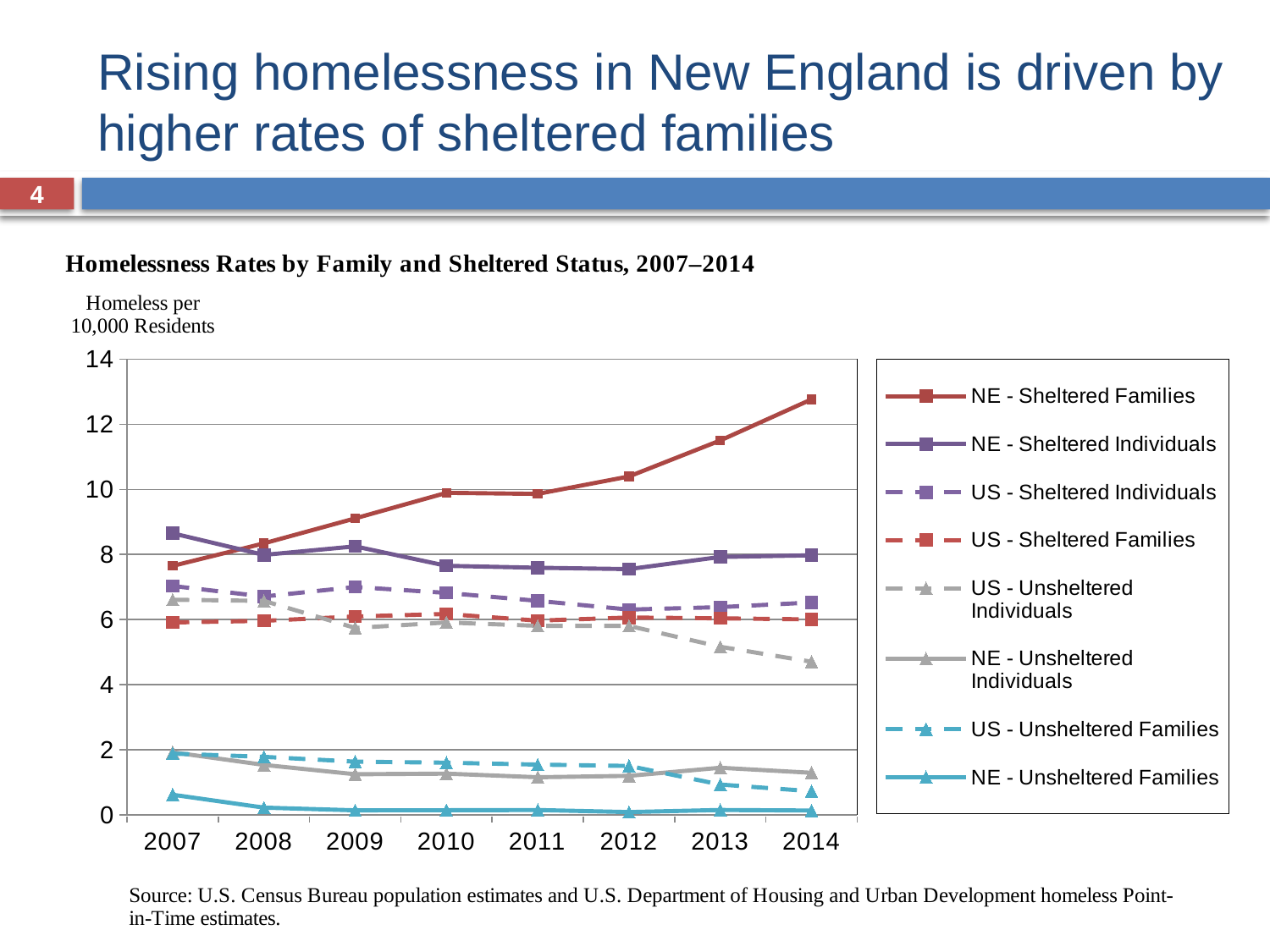
In 2007, which is higher: NE - Sheltered Individuals or NE - Sheltered Families? NE - Sheltered Individuals Does the NE - Sheltered Families line rise or fall from 2007 to 2014? Rise Is the value for NE - Sheltered Families in 2014 greater or less than 12? greater Does the US - Unsheltered Individuals line rise or fall from 2007 to 2014? Fall Is the value for NE - Sheltered Families in 2007 greater or less than 8? less What kind of chart is shown on the slide? Line chart What is the title of the chart? Homelessness Rates by Family and Sheltered Status, 2007–2014 How many series does the legend list? 8 Which series has the lowest value in 2014? NE - Unsheltered Families Which series has the highest value in 2014? NE - Sheltered Families Is the value for US - Unsheltered Individuals in 2014 greater or less than 6? less How many years are shown along the x axis? 8